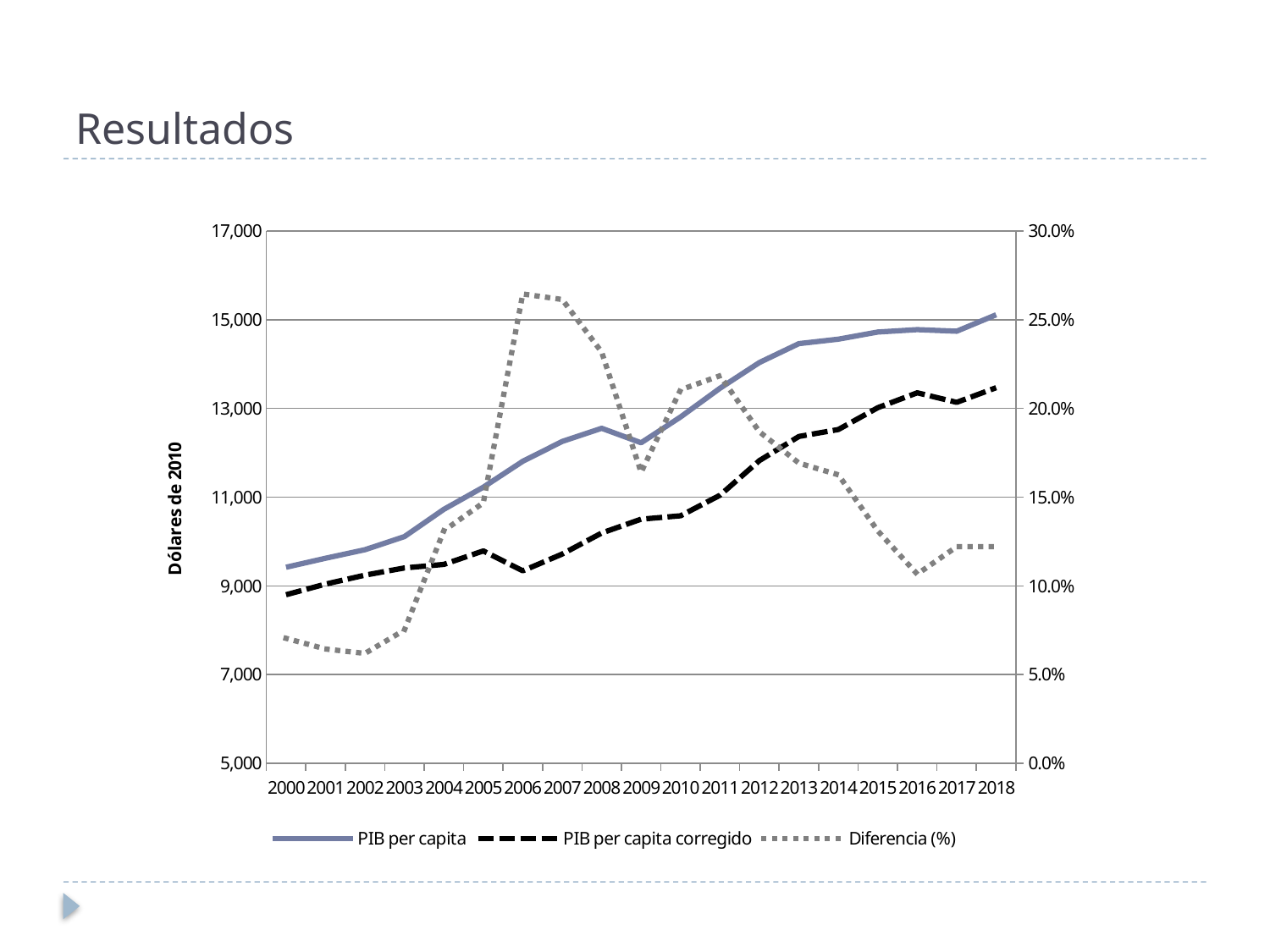
Which is larger in 2010, PIB per capita or PIB per capita corregido? PIB per capita What is the label of the left vertical axis? Dólares de 2010 Is the value for PIB per capita in 2013 greater or less than 14,000? greater In which year is PIB per capita highest? 2018 Is the value for Diferencia (%) in 2006 greater or less than 25.0%? greater In which year is PIB per capita lowest? 2000 How many series does the legend list? 3 What is the title of the slide containing the chart? Resultados Is the value for PIB per capita in 2000 greater or less than 10,000? less What kind of chart is shown on the slide? line chart How many years are plotted along the x axis? 19